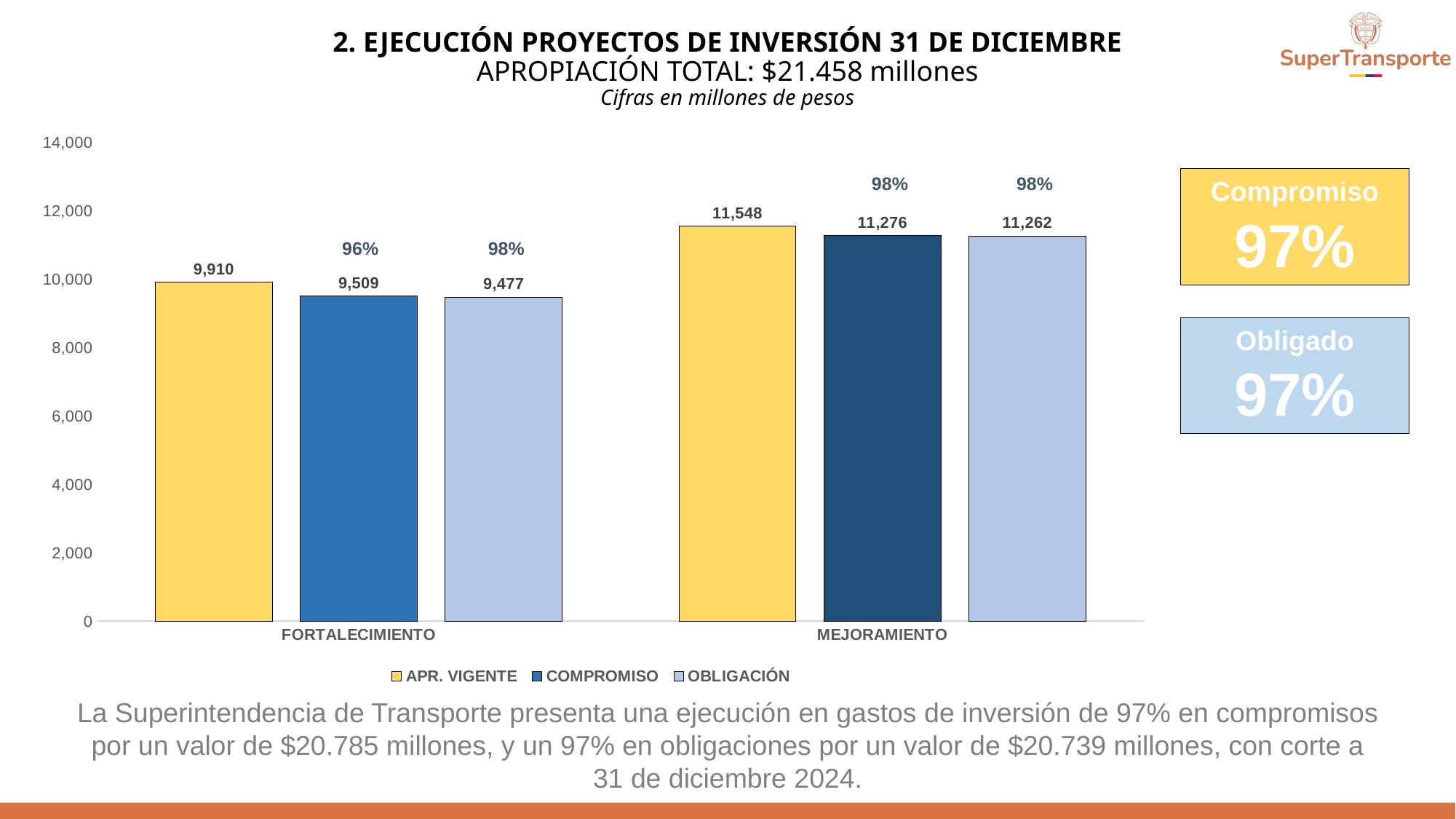
How many series does the legend list? 3 What is the difference between the COMPROMISO values for MEJORAMIENTO and FORTALECIMIENTO? 1,767 What is the OBLIGACIÓN value for FORTALECIMIENTO? 9,477 What is the difference between the APR. VIGENTE and COMPROMISO values for MEJORAMIENTO? 272 Is the COMPROMISO value for FORTALECIMIENTO larger or smaller than the OBLIGACIÓN value for FORTALECIMIENTO? larger Which category has the higher APR. VIGENTE value? MEJORAMIENTO What is the APR. VIGENTE value for FORTALECIMIENTO? 9,910 Which bar has the lowest value in the chart? OBLIGACIÓN for FORTALECIMIENTO How many categories are shown on the x axis? 2 What percentage is shown above the COMPROMISO bar for FORTALECIMIENTO? 96% What kind of chart is shown on the slide? bar chart What is the COMPROMISO value for MEJORAMIENTO? 11,276